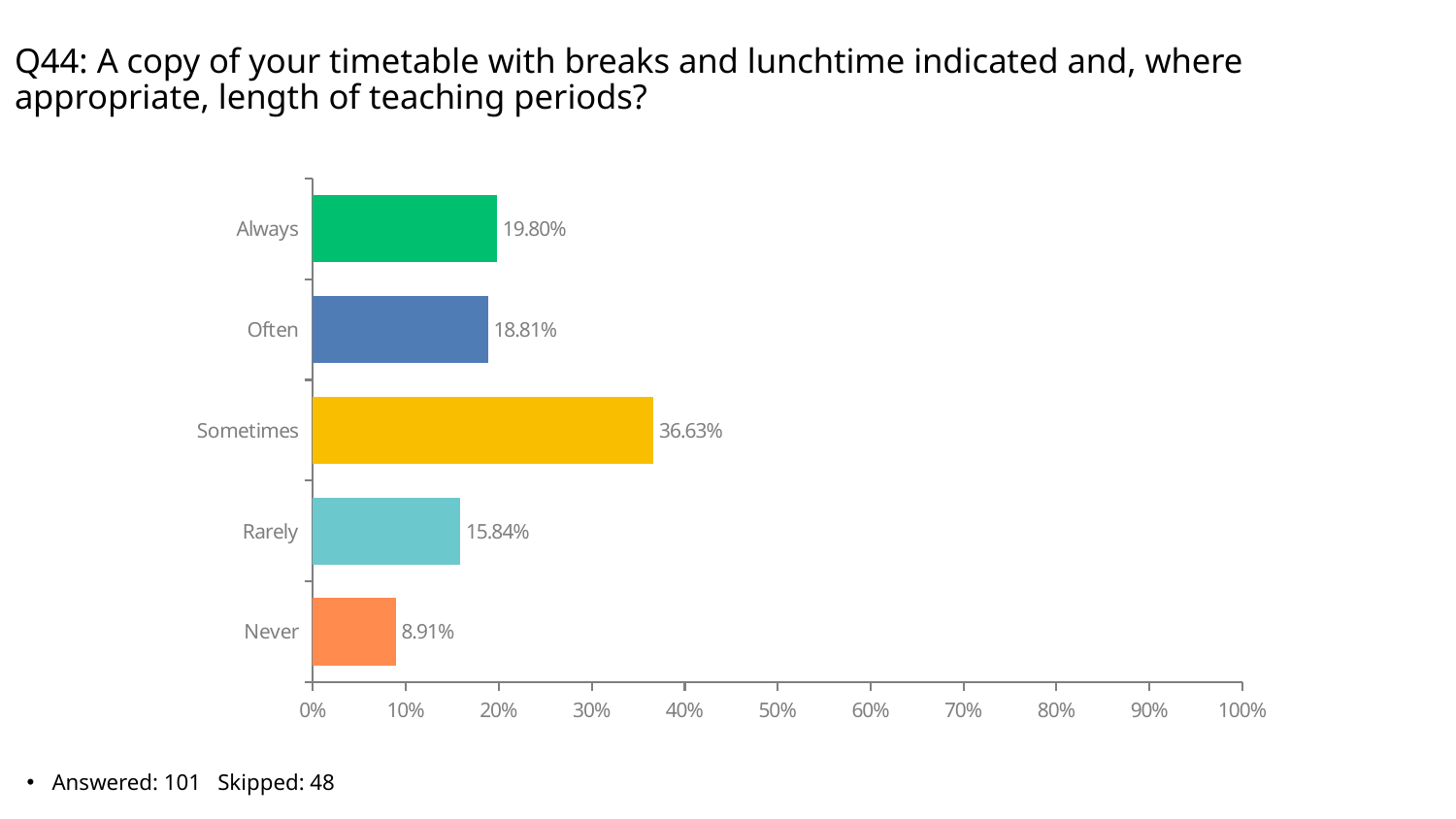
What is the value for Rarely? 15.84% Which category has the highest value? Sometimes What is the difference between the values for Sometimes and Never? 27.72% Which category has the lowest value? Never What kind of chart is shown on the slide? bar chart Is the value for Sometimes greater or less than 30%? greater What is the value for Never? 8.91% What is the value for Sometimes? 36.63% What is the value for Always? 19.80% How many categories are shown in the chart? 5 What colour is the bar for Sometimes? yellow Which is larger, the value for Sometimes or the value for Rarely? Sometimes